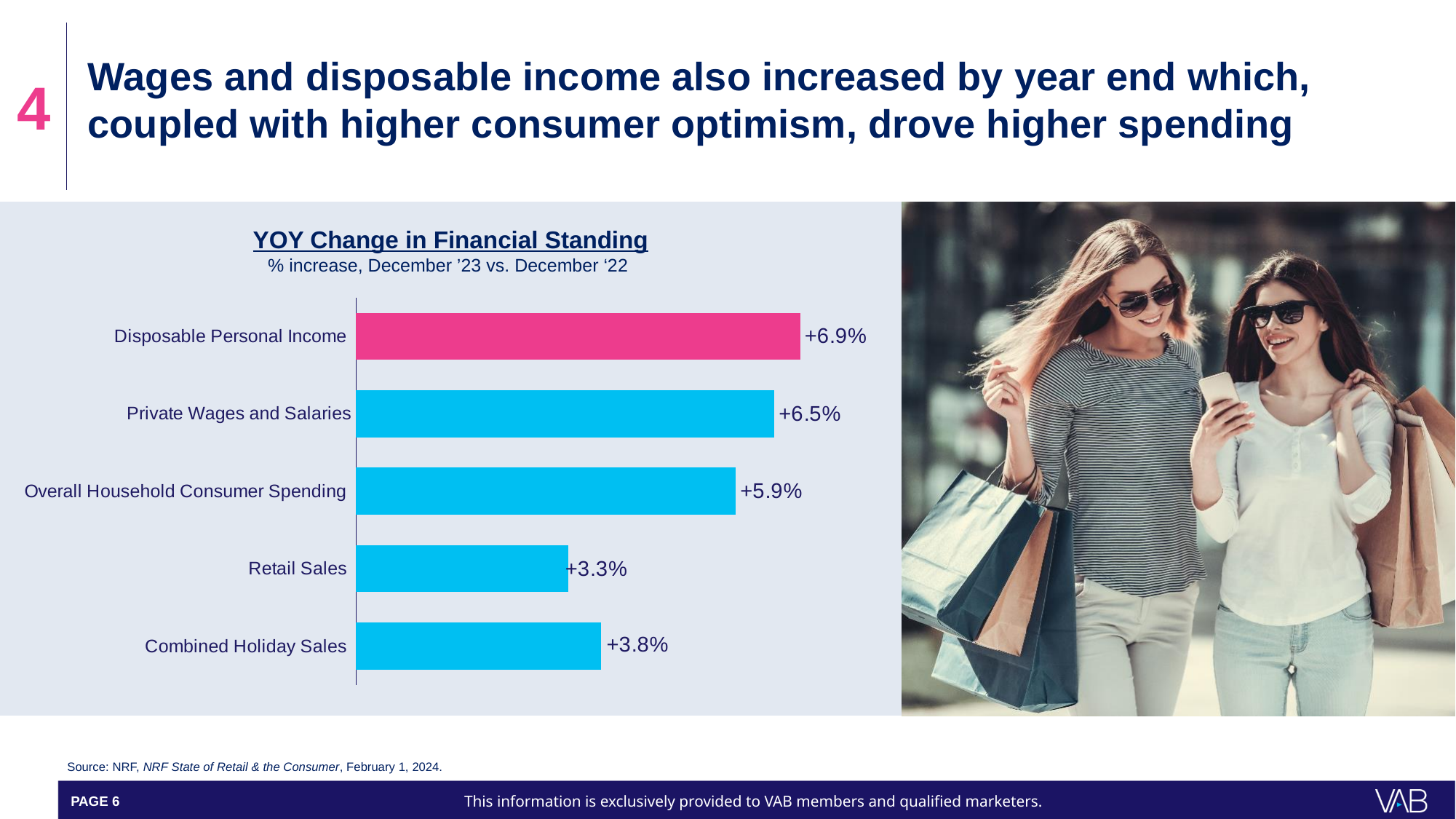
Which category has the lowest YOY change? Retail Sales What is the title of the chart? YOY Change in Financial Standing What is the YOY change for Overall Household Consumer Spending? +5.9% What is the YOY change for Private Wages and Salaries? +6.5% What is the YOY change for Combined Holiday Sales? +3.8% How many categories are shown in the chart? 5 Which is larger, the YOY change for Combined Holiday Sales or for Retail Sales? Combined Holiday Sales What is the difference in percentage points between Disposable Personal Income and Retail Sales? 3.6 Which category has the highest YOY change? Disposable Personal Income What is the YOY change for Retail Sales? +3.3% What is the YOY change for Disposable Personal Income? +6.9% What type of chart is shown on the slide? Bar chart